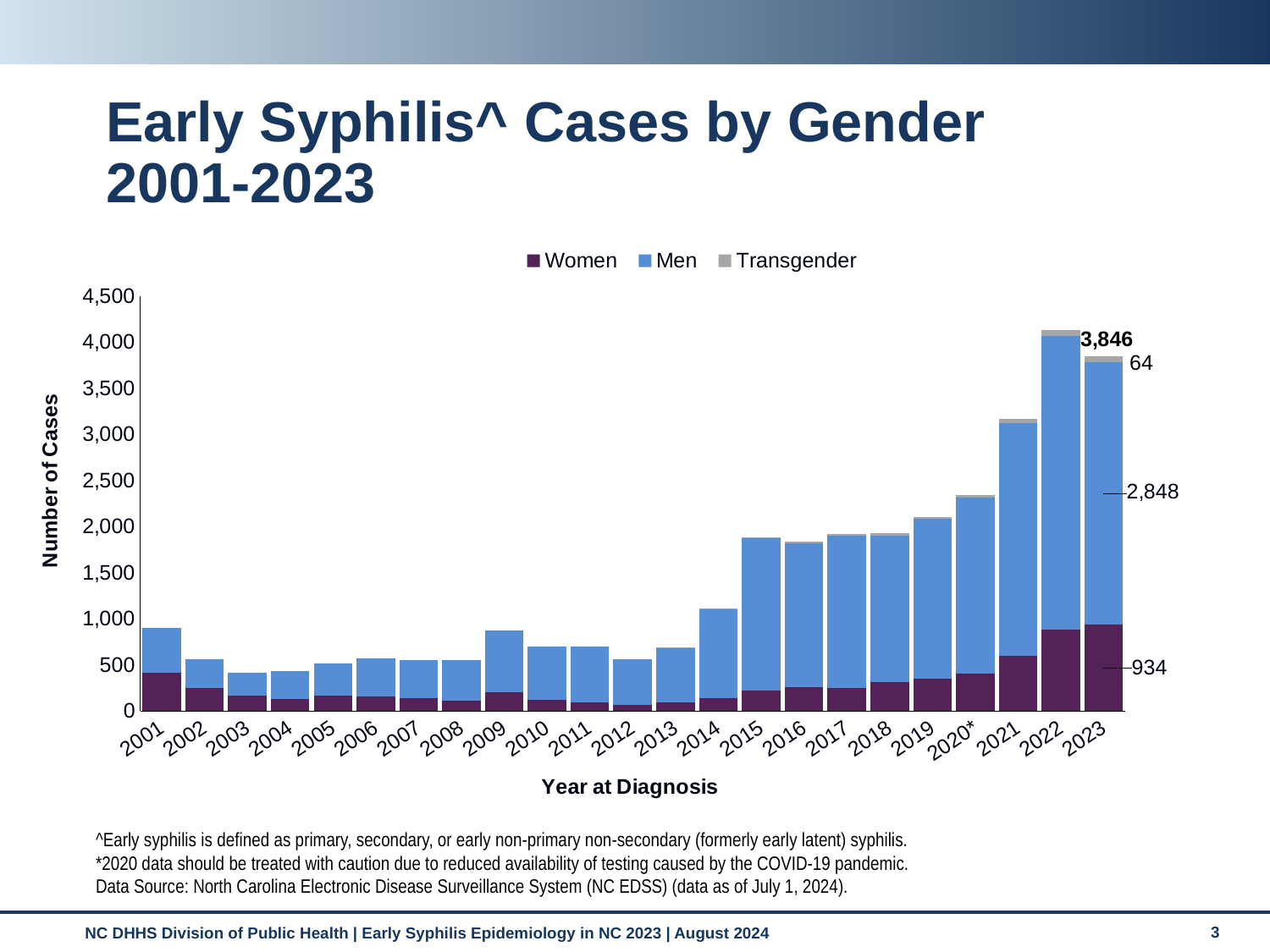
How many years are shown along the x axis? 23 Is the total number of cases in 2022 greater or less than 4,000? greater How many early syphilis cases among transgender people are labeled for 2023? 64 How many early syphilis cases among women are labeled for 2023? 934 What is the title of the x axis? Year at Diagnosis What is the difference between the number of cases among men and among women in 2023? 1,914 Which year has the highest total number of cases? 2022 How many series does the legend list? 3 How many early syphilis cases among men are labeled for 2023? 2,848 In 2023, which group had more cases, men or women? Men What kind of chart is shown on the slide? bar chart What is the total number of early syphilis cases labeled for 2023? 3,846